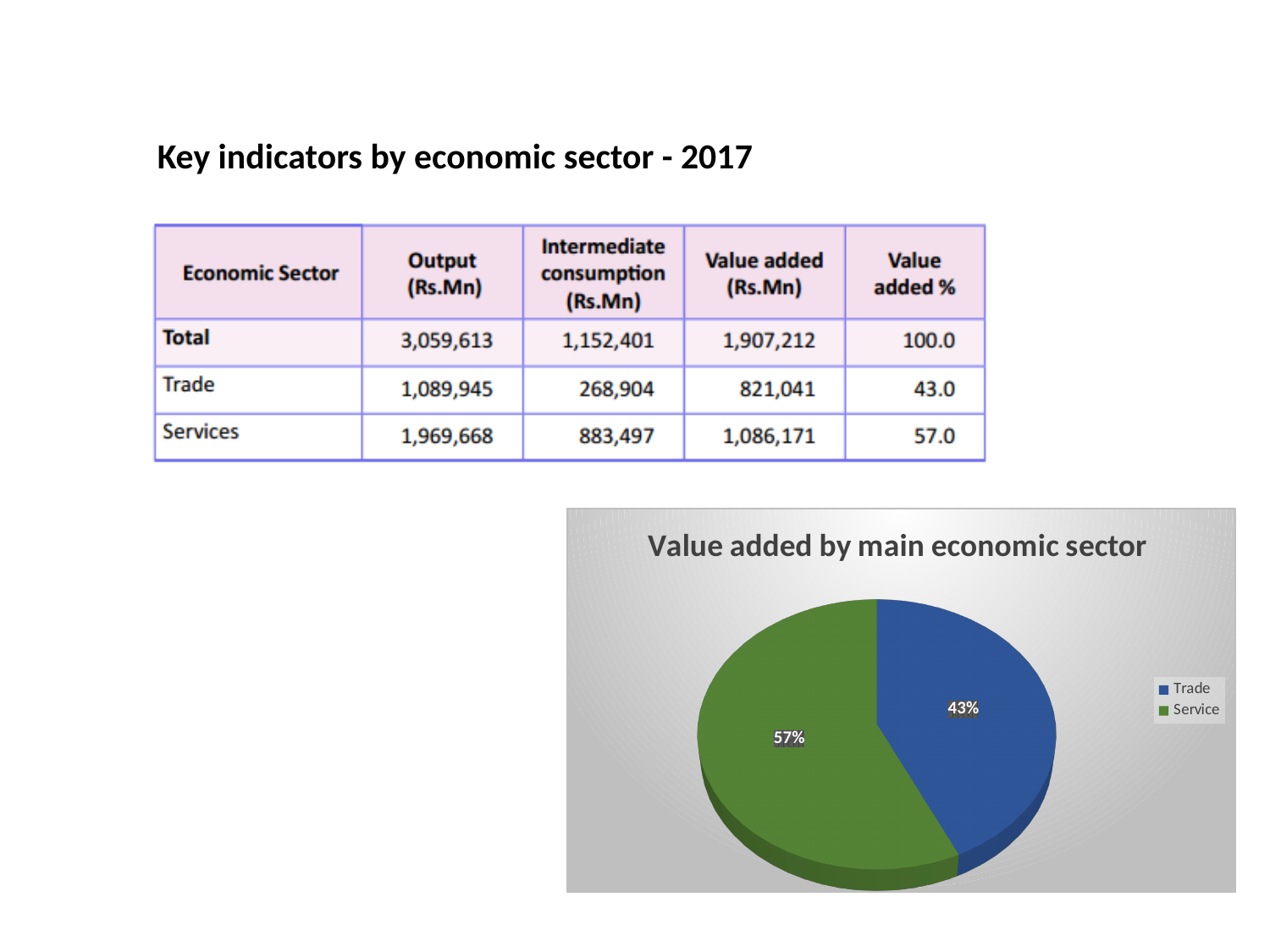
What share of the pie does Service have? 57% What is the difference in percentage points between the Service slice and the Trade slice? 14 Which sector has the smallest slice of the pie? Trade What colour is the Trade slice in the pie chart? blue Which is larger, the Trade slice or the Service slice? Service Which sector has the largest slice of the pie? Service How many entries does the legend list? 2 What share of the pie does Trade have? 43% What kind of chart is shown on the slide? pie chart How many slices does the pie chart have? 2 What is the title of the chart? Value added by main economic sector